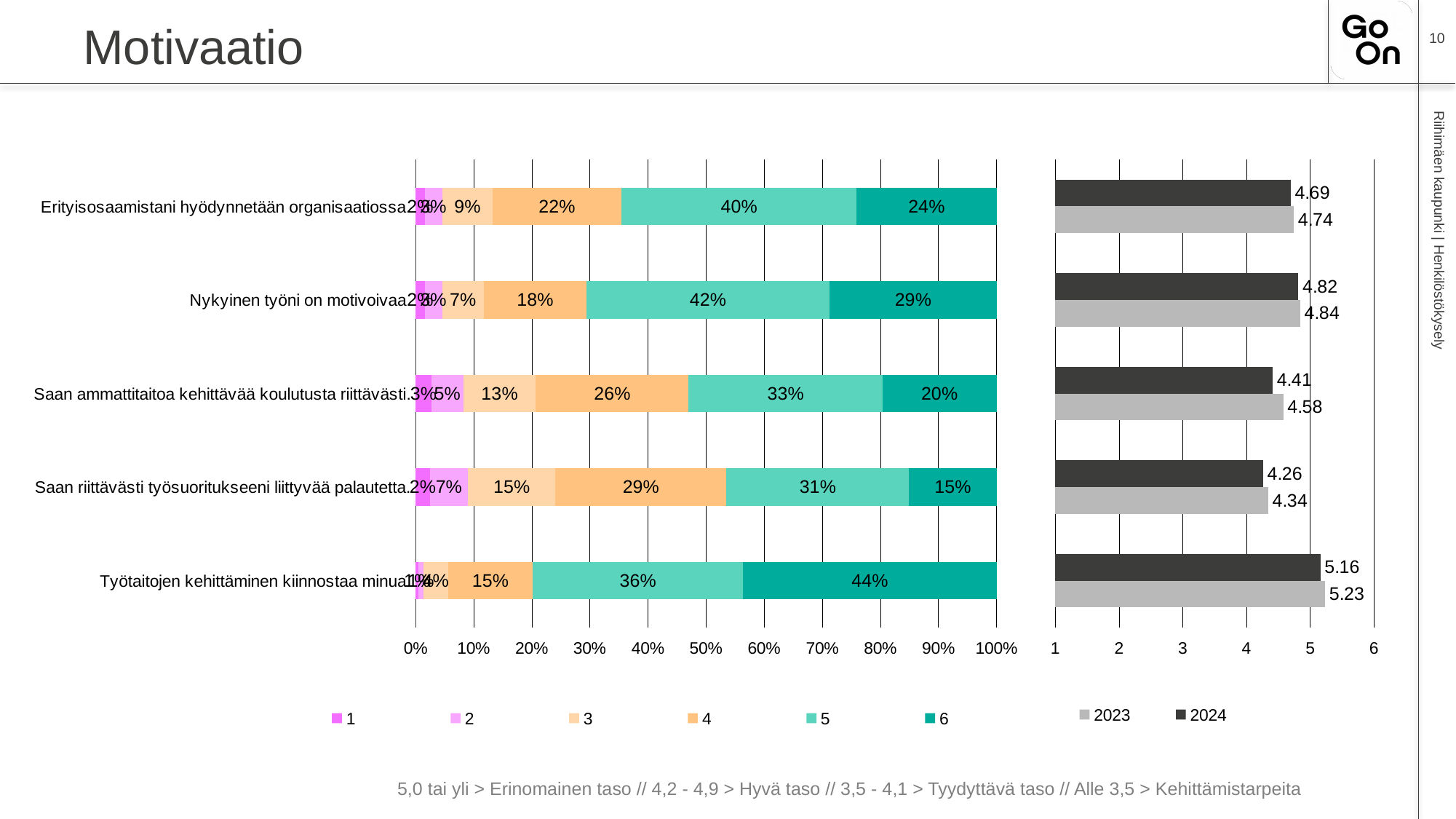
In the left stacked bar chart, what is the difference between the rating-5 share and the rating-6 share for "Erityisosaamistani hyödynnetään organisaatiossa"? 16 percentage points In the left stacked bar chart, what percentage gave a rating of 5 for "Nykyinen työni on motivoivaa"? 42% In the left stacked bar chart, what percentage of respondents gave a rating of 6 for "Työtaitojen kehittäminen kiinnostaa minua"? 44% In the left stacked bar chart, which statement has the lowest share of rating 6? Saan riittävästi työsuoritukseeni liittyvää palautetta In the right bar chart, is the 2023 value for "Nykyinen työni on motivoivaa" larger or smaller than its 2024 value? larger What kind of chart is the chart on the right? bar chart In the right bar chart, what is the 2024 value for "Työtaitojen kehittäminen kiinnostaa minua"? 5.16 In the left stacked bar chart, which statement has the highest share of rating 6? Työtaitojen kehittäminen kiinnostaa minua In the right bar chart, what is the 2023 value for "Saan ammattitaitoa kehittävää koulutusta riittävästi"? 4.58 In the right bar chart, which statement has the lowest 2024 value? Saan riittävästi työsuoritukseeni liittyvää palautetta How many series does the legend of the left stacked bar chart list? 6 In the left stacked bar chart, what percentage gave a rating of 4 for "Saan riittävästi työsuoritukseeni liittyvää palautetta"? 29%